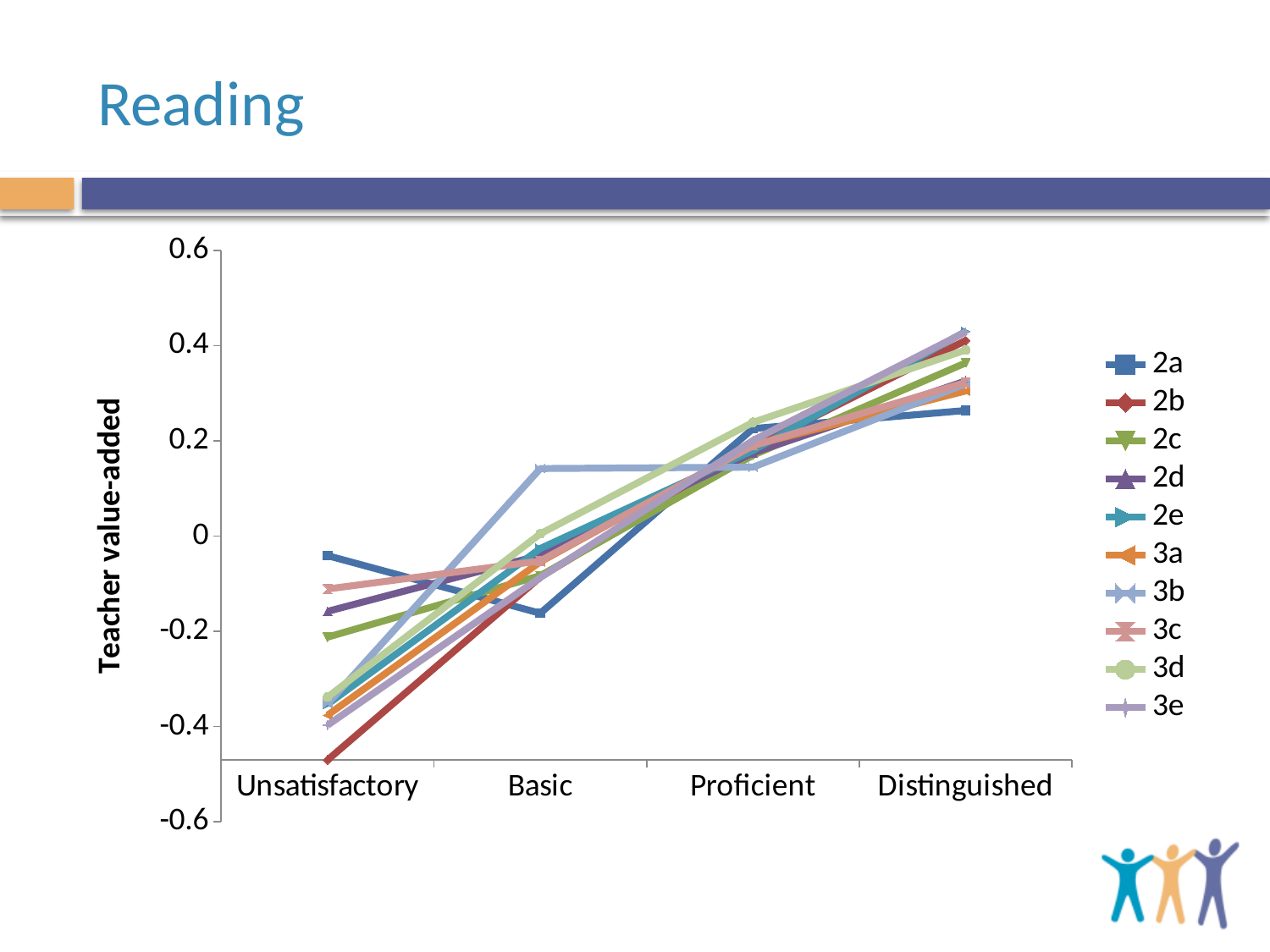
How many series does the legend list? 10 Which series has the lowest value at Distinguished? 2a Which series has the highest value at Unsatisfactory? 2a Do the values for 2b rise or fall from Unsatisfactory to Distinguished? rise How many categories are shown on the x axis? 4 What is the label of the y axis? Teacher value-added Which is larger at Basic: the value for 2a or the value for 3b? 3b Is the value for 3b at Basic greater or less than 0? greater Is the value for 2b at Unsatisfactory greater or less than -0.4? less Is the value for 2a at Distinguished greater or less than 0.4? less Which series has the lowest value at Unsatisfactory? 2b What kind of chart is shown on the slide? line chart